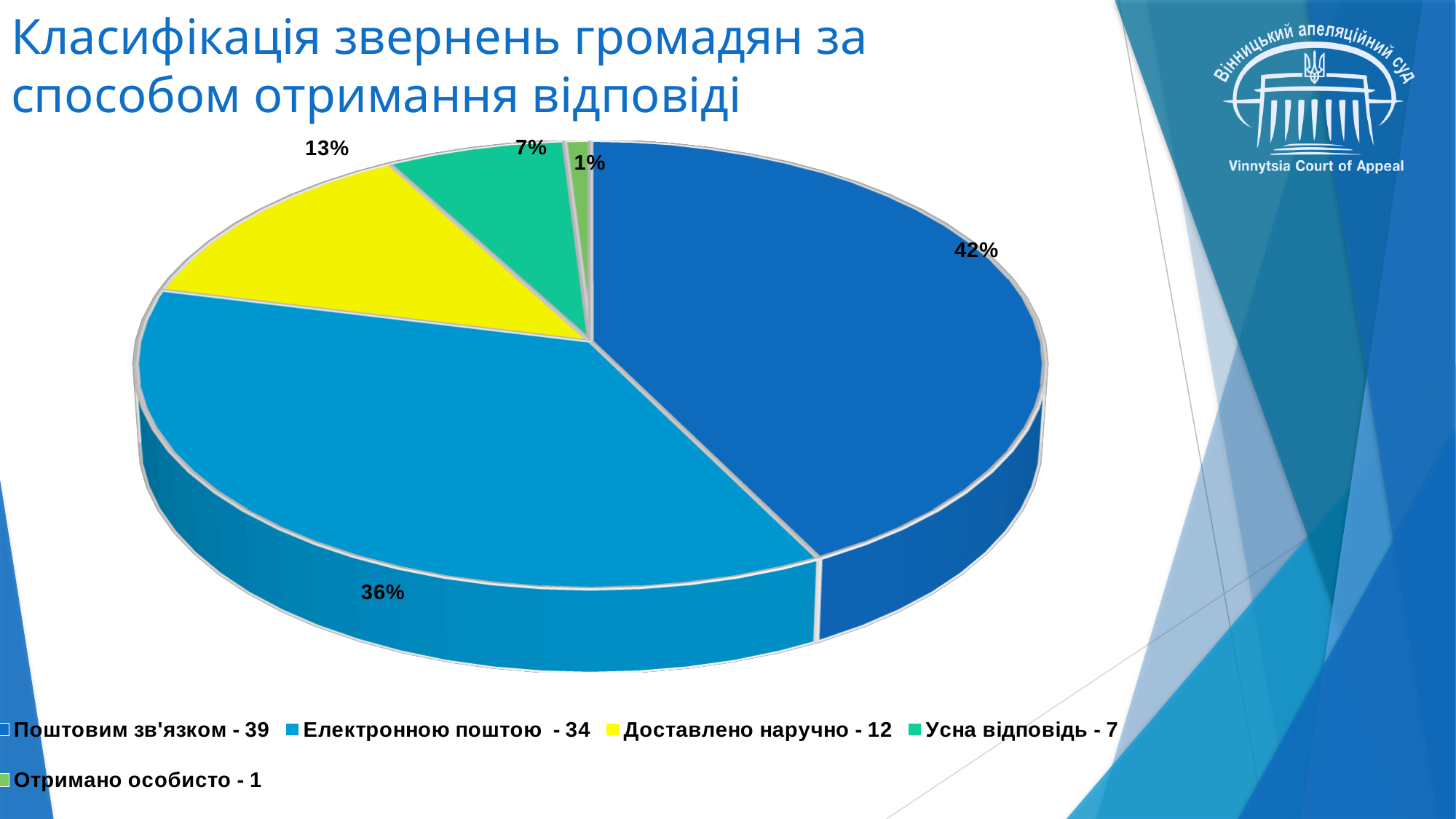
Which is larger: the slice for 'Доставлено наручно' or the slice for 'Усна відповідь'? Доставлено наручно What percentage share does the slice for 'Поштовим зв'язком' have? 42% What percentage share does the slice for 'Електронною поштою' have? 36% What is the title of the chart on the slide? Класифікація звернень громадян за способом отримання відповіді What percentage share does the slice for 'Доставлено наручно' have? 13% How many slices does the pie chart have? 5 Which category has the largest slice of the pie? Поштовим зв'язком What is the difference in percentage points between the 'Поштовим зв'язком' slice and the 'Електронною поштою' slice? 6% According to the legend, how many responses were delivered by 'Електронною поштою'? 34 What kind of chart is shown on the slide? pie chart Which category has the smallest slice of the pie? Отримано особисто